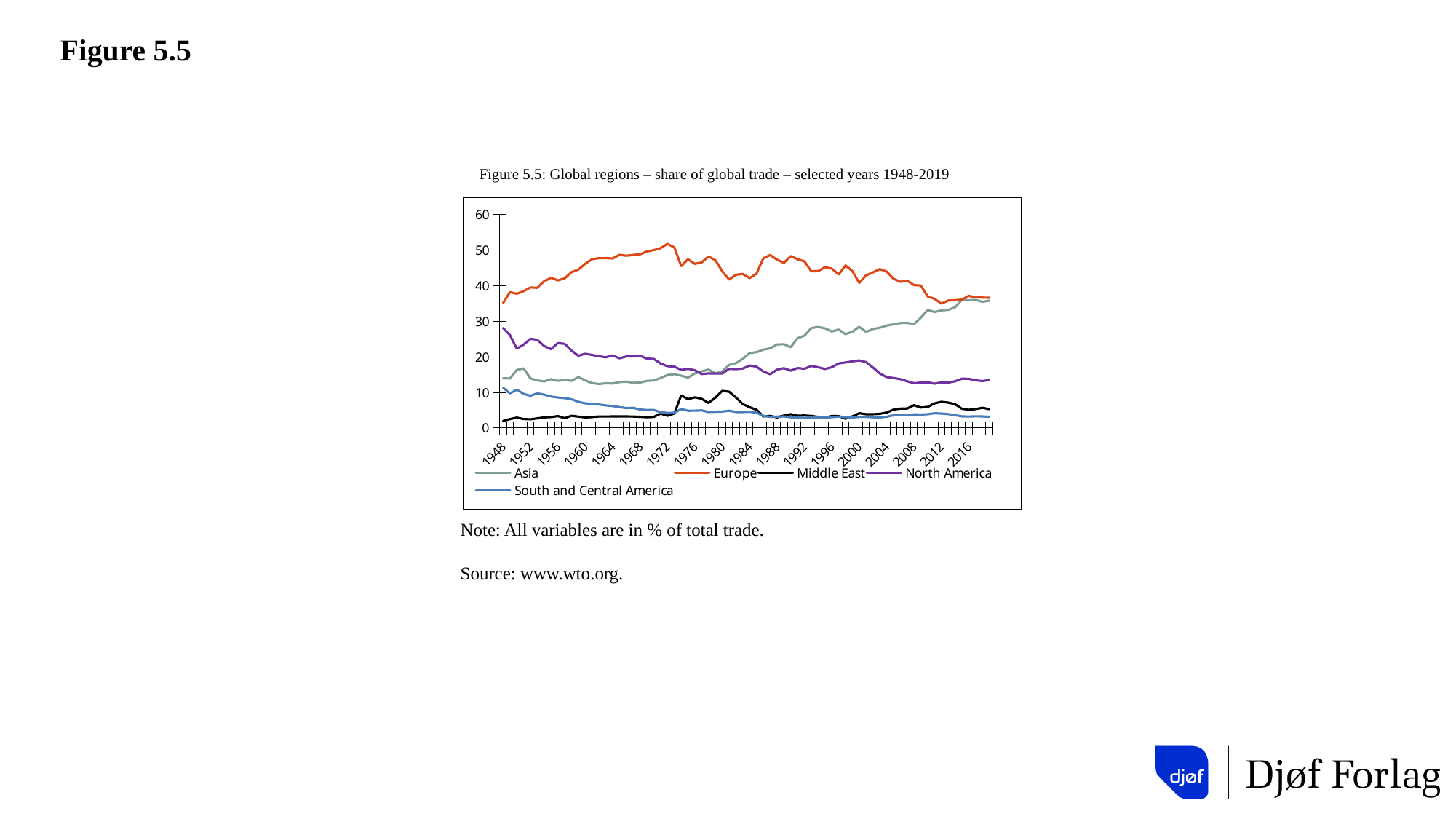
Is the value for Asia in 1948 greater or less than 20? less Which region has the highest share of global trade in 1948? Europe What kind of chart is shown on the slide? line chart Which region has the lowest share of global trade in 1948? Middle East Does the share for Asia rise or fall overall from 1948 to the end of the series? rise How many series does the legend list? 5 Is the value for Europe in 1948 greater or less than 30? greater Which is larger in 1980, the share for Europe or the share for Asia? Europe What is the title of the chart? Figure 5.5: Global regions – share of global trade – selected years 1948-2019 Does the share for North America rise or fall overall from 1948 to the end of the series? fall Is the value for North America in 1948 greater or less than 20? greater